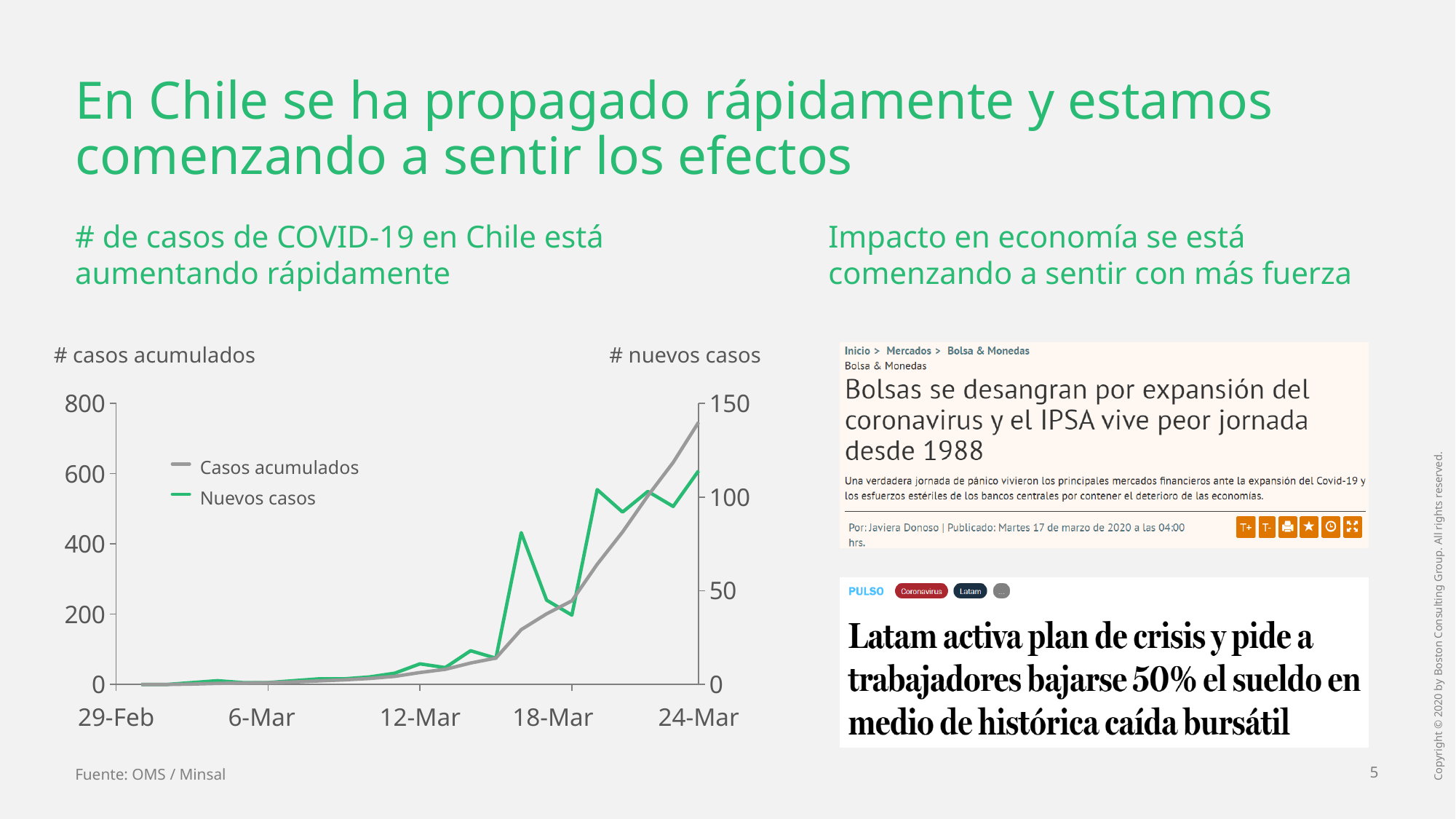
What kind of chart is shown on the slide? line chart What is the label of the left vertical axis of the chart? # casos acumulados How many series does the chart legend list? 2 Which date on the x axis has the highest value of Casos acumulados? 24-Mar What are the two series named in the chart legend? Casos acumulados and Nuevos casos Is the value of Casos acumulados at 6-Mar greater or less than 200? less How many date labels are shown on the x axis of the chart? 5 Is the value of Nuevos casos at 24-Mar greater or less than 100? greater Is the value of Nuevos casos at 12-Mar greater or less than 50? less Does the Casos acumulados line rise or fall from 29-Feb to 24-Mar? rise